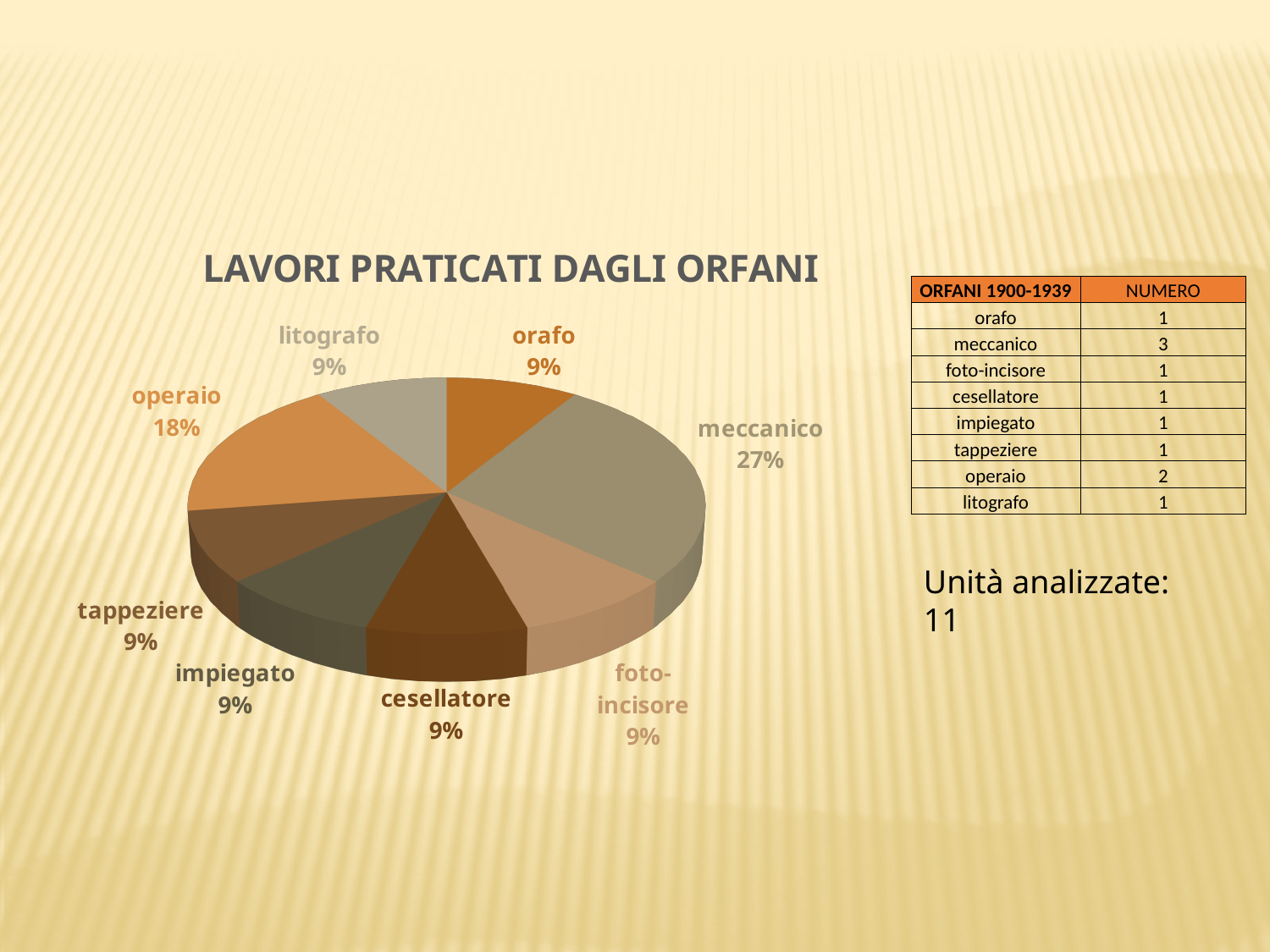
What type of chart is shown on the slide? pie chart What percentage is shown for foto-incisore? 9% What percentage is shown for litografo? 9% Which is larger, the slice for operaio or the slice for orafo? operaio What is the title of the chart? LAVORI PRATICATI DAGLI ORFANI What percentage is shown for tappeziere? 9% Which category has the largest slice of the pie? meccanico Is the share for meccanico greater or less than 25%? greater What share of the pie does operaio represent? 18% How many slices does the pie chart have? 8 What is the difference in percentage points between meccanico and operaio? 9 What share of the pie does meccanico represent? 27%